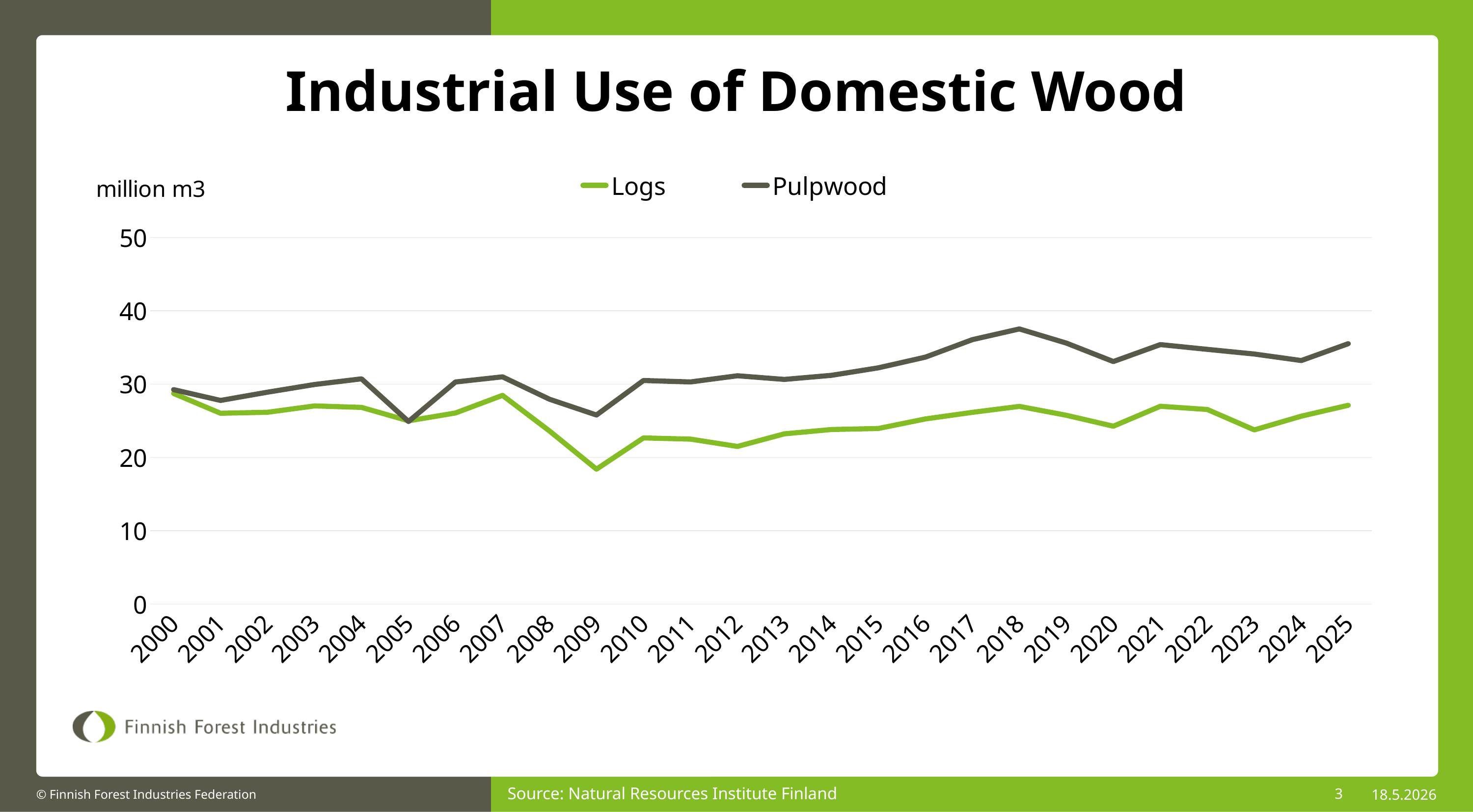
In which year does the Logs series reach its lowest value? 2009 Is the value for Logs in 2009 greater or less than 20? less What unit is shown for the y axis? million m3 Is the value for Logs in 2023 greater or less than 30? less How many years are plotted along the x axis? 26 Is the value for Pulpwood in 2017 greater or less than 30? greater How many series does the legend list? 2 In 2009, which series has the larger value, Logs or Pulpwood? Pulpwood What kind of chart is shown on the slide? line chart In which year does the Pulpwood series reach its highest value? 2018 Does the Pulpwood series rise or fall from 2009 to 2018? rise